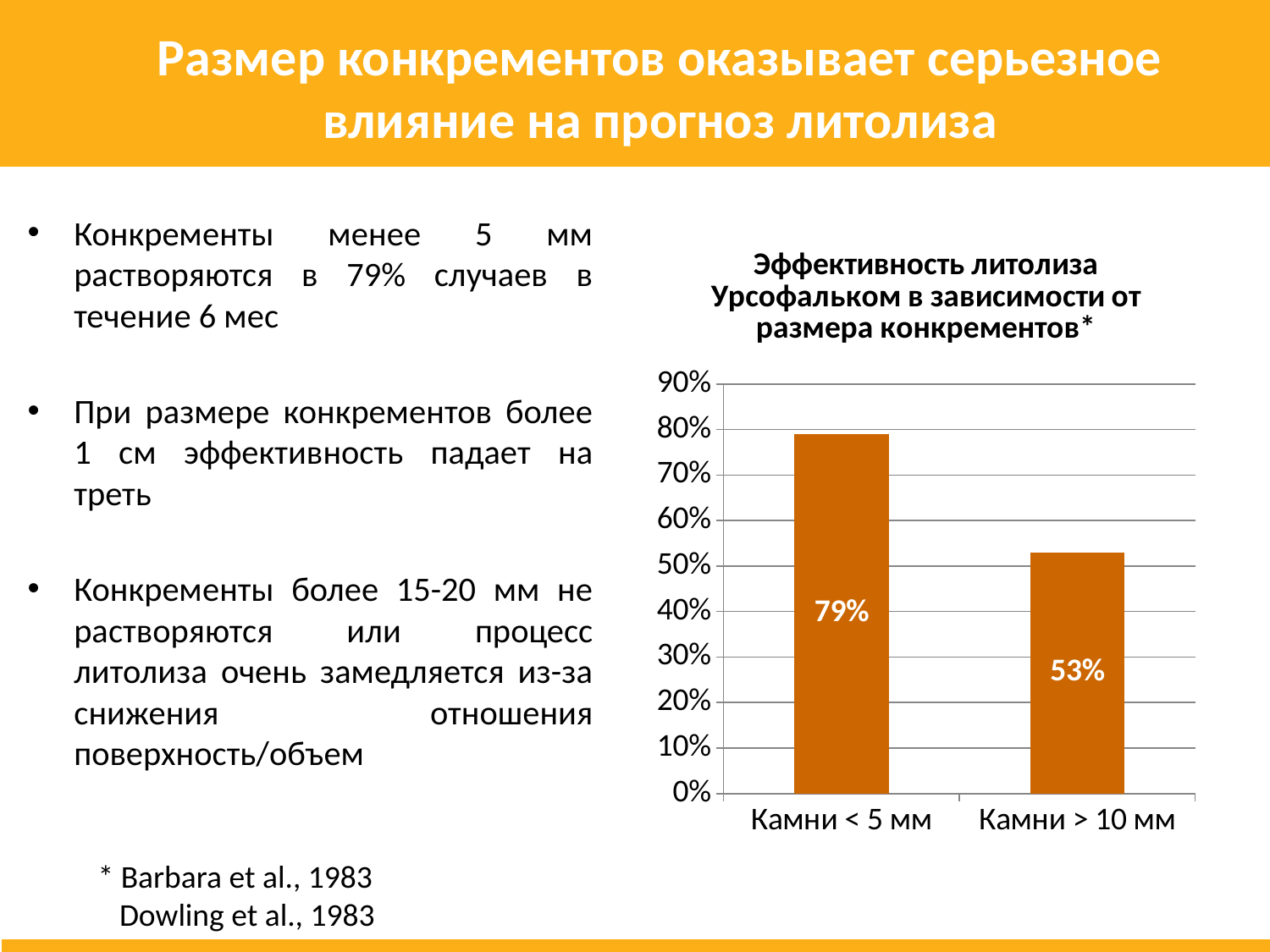
What is the highest value shown on the y axis? 90% What is the value for Камни > 10 мм? 53% Is the value for Камни > 10 мм greater or less than 60%? less Is the value for Камни < 5 мм greater or less than 70%? greater What kind of chart is shown on the slide? bar chart How many categories are shown on the chart? 2 What is the title of the chart? Эффективность литолиза Урсофальком в зависимости от размера конкрементов* Which category has the lowest value? Камни > 10 мм Which is larger, the value for Камни < 5 мм or the value for Камни > 10 мм? Камни < 5 мм Which category has the highest value? Камни < 5 мм What is the difference between the values for Камни < 5 мм and Камни > 10 мм? 26% What is the value for Камни < 5 мм? 79%